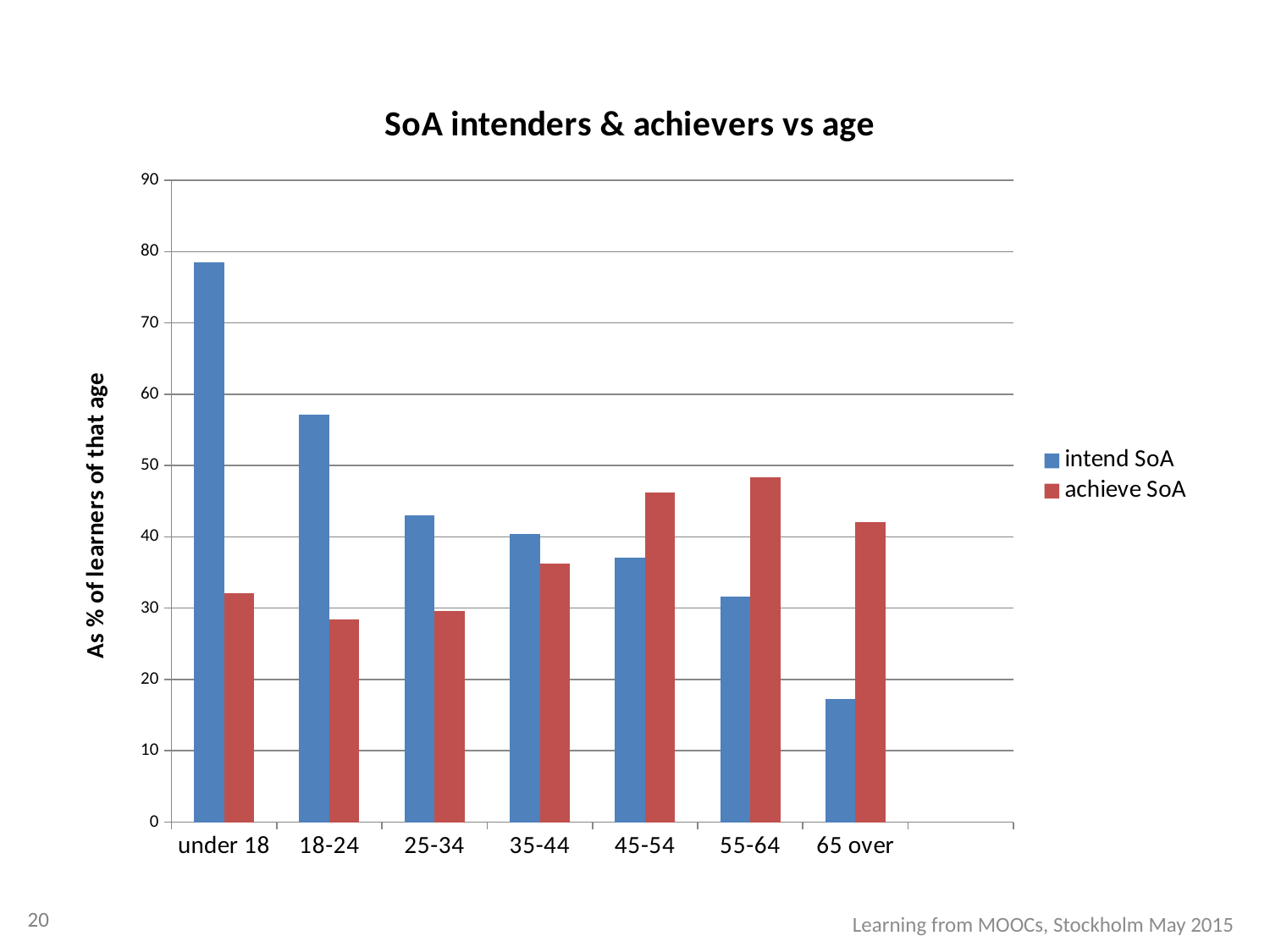
For the 65 over age group, which is larger: intend SoA or achieve SoA? achieve SoA Is the intend SoA value for under 18 greater or less than 70? greater Which age group has the highest value for intend SoA? under 18 What kind of chart is shown on the slide? bar chart For the 18-24 age group, which is larger: intend SoA or achieve SoA? intend SoA Is the achieve SoA value for 18-24 greater or less than 30? less Is the intend SoA value for 65 over greater or less than 20? less Do the intend SoA values rise or fall as age increases along the x axis? fall Which age group has the lowest value for intend SoA? 65 over How many series does the legend list? 2 How many age categories are shown on the x axis? 7